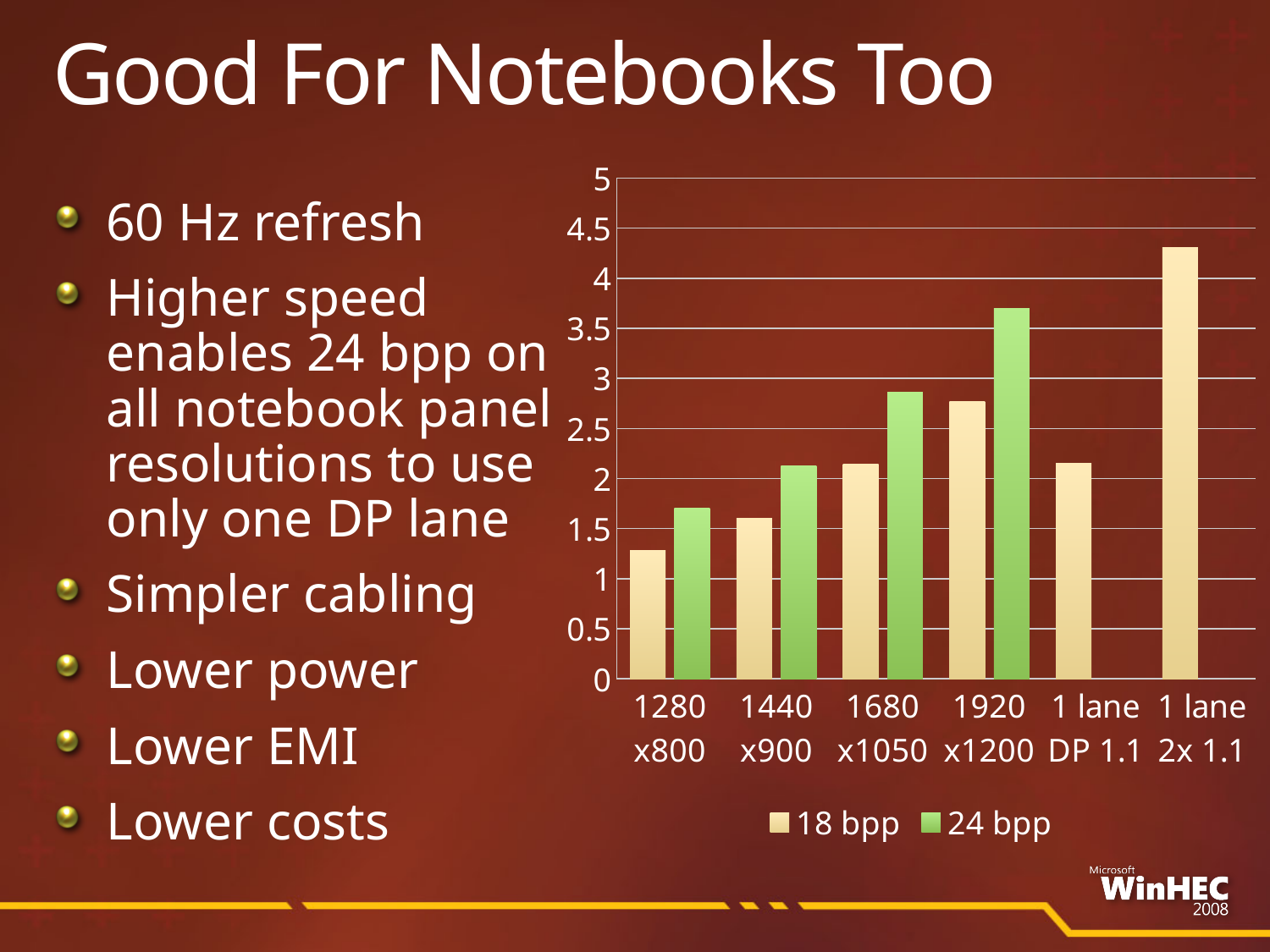
Is the 18 bpp value for 1280 x800 greater or less than 1.5? less Is the 18 bpp value for 1 lane 2x 1.1 greater or less than 4? greater Which category has the highest 24 bpp value? 1920 x1200 Which category has the lowest 18 bpp value? 1280 x800 At 1920 x1200, which series has the larger value, 18 bpp or 24 bpp? 24 bpp Which category has the highest 18 bpp value? 1 lane 2x 1.1 Is the 24 bpp value for 1920 x1200 greater or less than 3.5? greater Do the 18 bpp values rise or fall from 1280 x800 to 1920 x1200? rise What colour are the 24 bpp bars in the chart? green What kind of chart is shown on the slide? bar chart How many series does the chart's legend list? 2 How many categories are shown along the x axis of the chart? 6